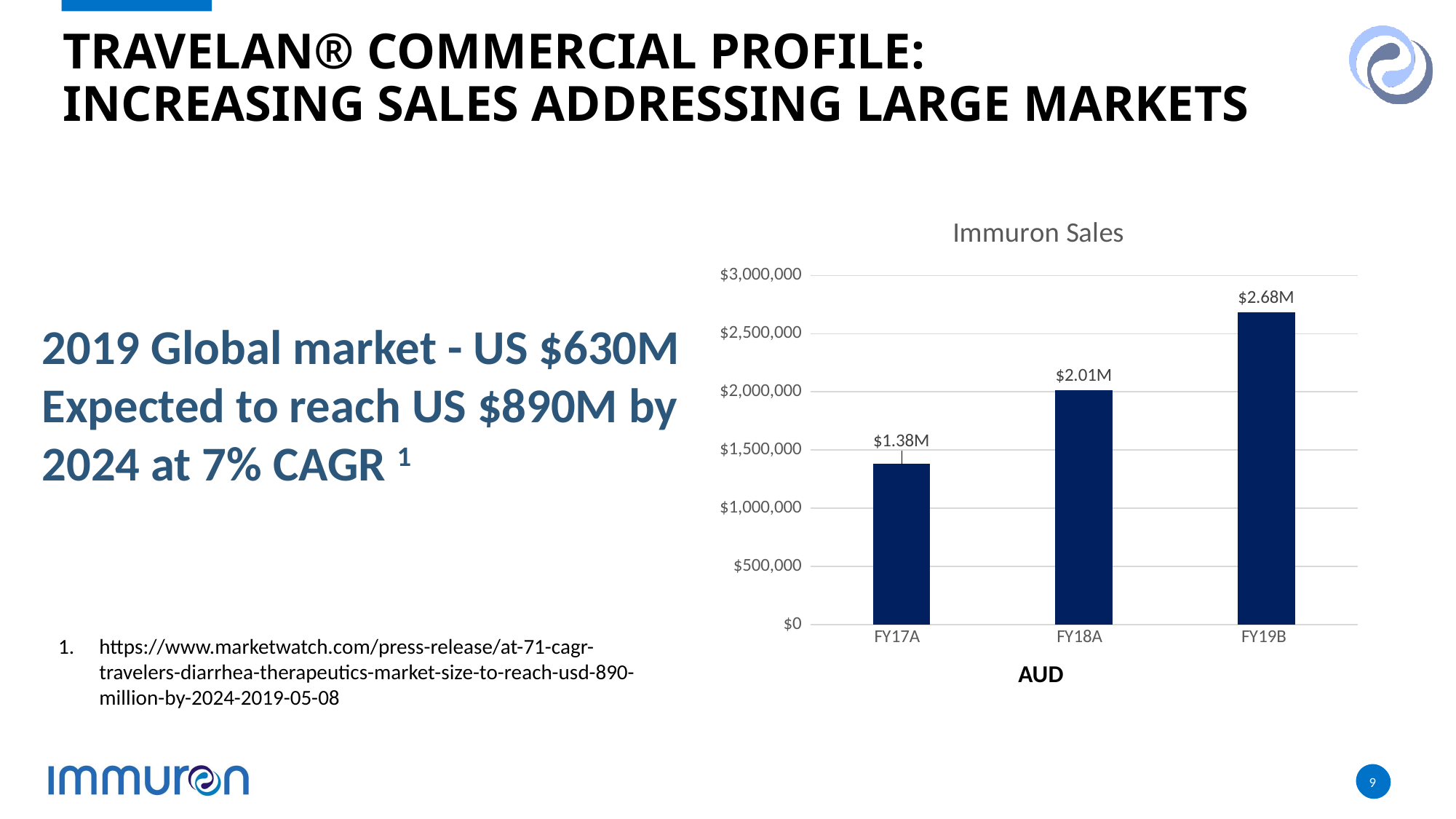
What kind of chart is the Immuron Sales chart? bar chart What is the difference between the FY19B and FY18A values in the Immuron Sales chart? $0.67M Which fiscal year has the highest sales in the Immuron Sales chart? FY19B How many fiscal years are shown in the Immuron Sales chart? 3 Do the sales values rise or fall from FY17A to FY19B in the Immuron Sales chart? rise What is the difference between the FY18A and FY17A values in the Immuron Sales chart? $0.63M What is the value for FY19B in the Immuron Sales chart? $2.68M What is the value for FY18A in the Immuron Sales chart? $2.01M Is the value for FY19B greater or less than $2,500,000? greater Which is larger in the Immuron Sales chart, FY17A or FY18A? FY18A What is the value for FY17A in the Immuron Sales chart? $1.38M Which fiscal year has the lowest sales in the Immuron Sales chart? FY17A